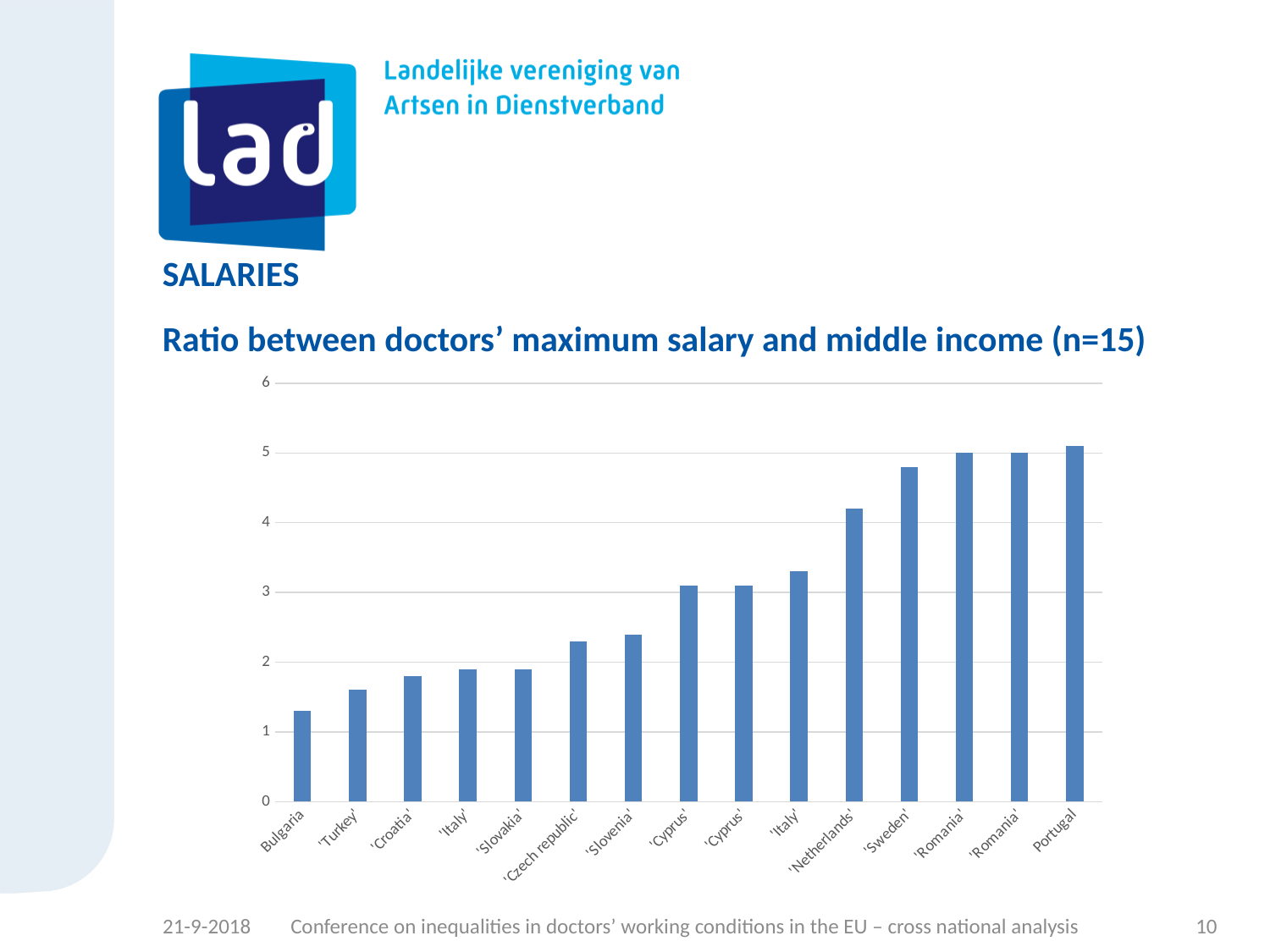
How many bars (countries) are plotted in the chart? 15 Is the value for Czech republic greater or less than 2? greater Is the value for Netherlands greater or less than 4? greater Which has the larger value, Netherlands or Sweden? Sweden Is the value for Bulgaria greater or less than 2? less Do the values generally rise or fall from left to right along the x axis? rise What kind of chart is shown on the slide? bar chart Which country has the highest ratio between doctors' maximum salary and middle income? Portugal What is the title of the chart? Ratio between doctors' maximum salary and middle income (n=15) Which country has the lowest ratio between doctors' maximum salary and middle income? Bulgaria